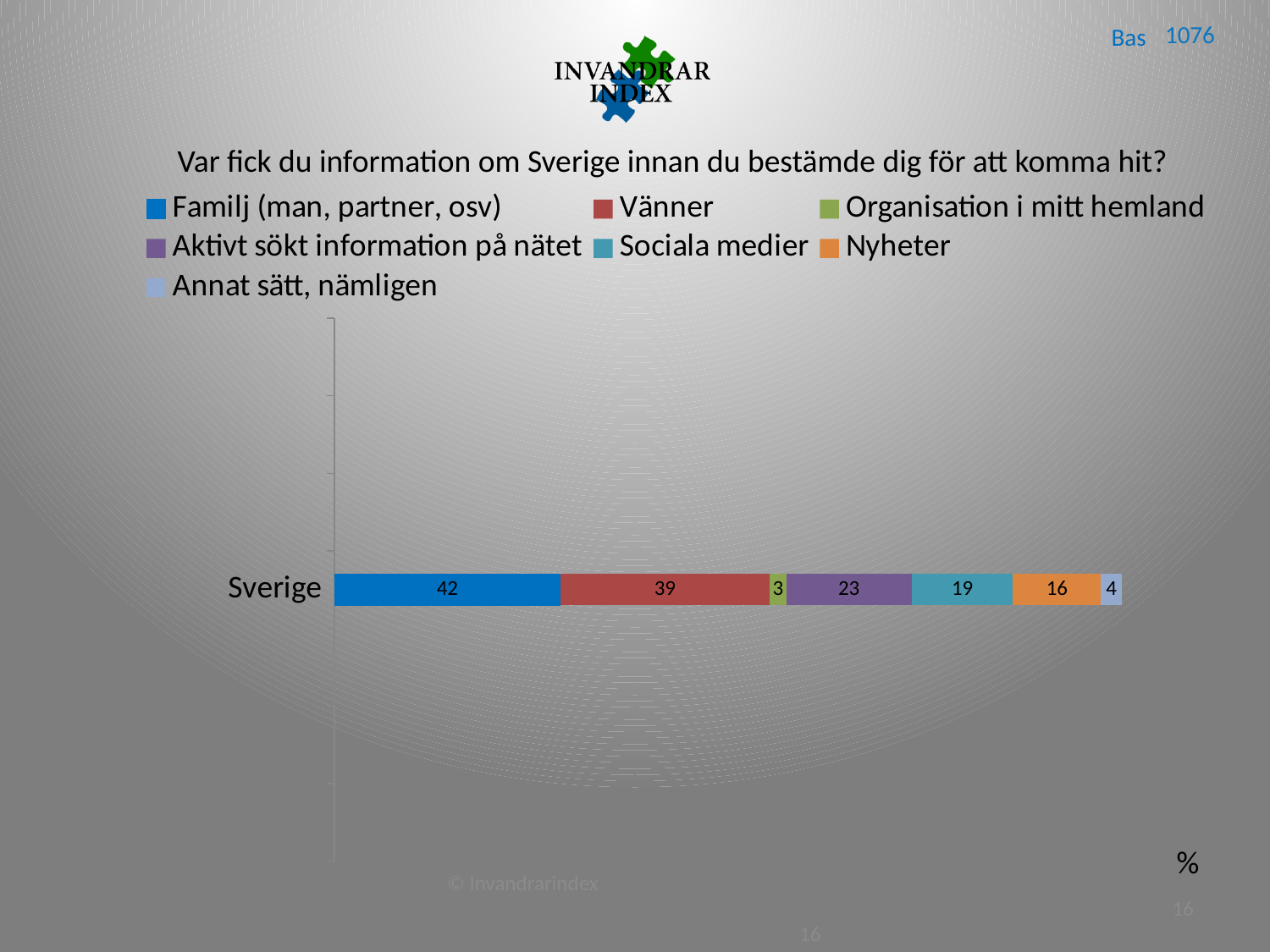
What is the value for Aktivt sökt information på nätet for Sverige? 23 What is the value for Vänner for Sverige? 39 Which series has the highest value for Sverige? Familj (man, partner, osv) How many series does the legend list? 7 Which series has the lowest value for Sverige? Organisation i mitt hemland What is the value for Familj (man, partner, osv) for Sverige? 42 What is the difference between the values for Familj (man, partner, osv) and Vänner for Sverige? 3 What is the value for Nyheter for Sverige? 16 Which is larger for Sverige, Sociala medier or Nyheter? Sociala medier What is the value for Sociala medier for Sverige? 19 What kind of chart is shown on the slide? Stacked bar chart What is the total of the stacked bar for Sverige? 146